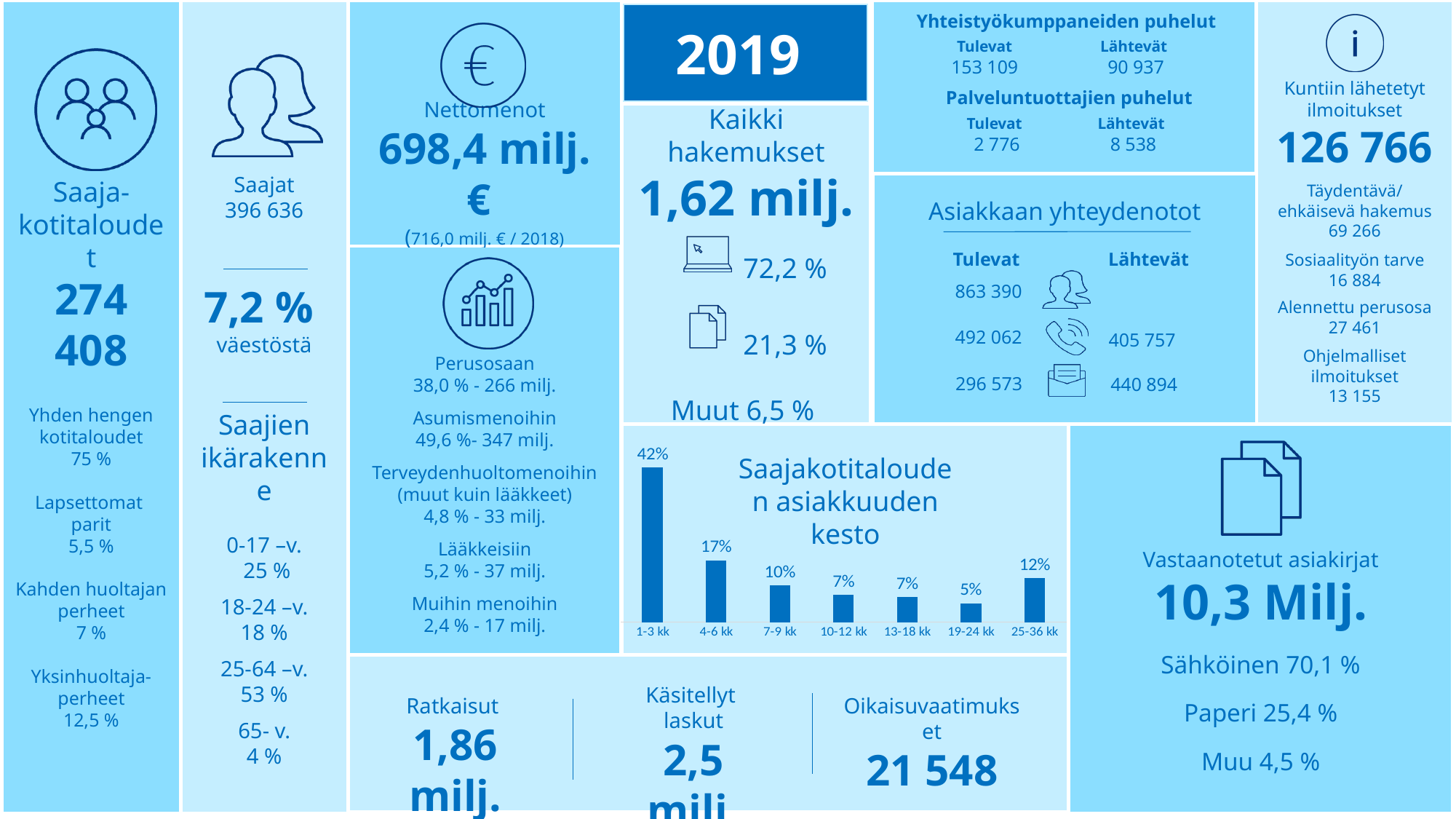
Which category has the lowest value in the Saajakotitalouden asiakkuuden kesto chart? 19-24 kk What is the value for the 4-6 kk category in the Saajakotitalouden asiakkuuden kesto chart? 17% What kind of chart is the Saajakotitalouden asiakkuuden kesto chart? Bar chart How many categories are shown in the Saajakotitalouden asiakkuuden kesto chart? 7 What is the value for the 1-3 kk category in the Saajakotitalouden asiakkuuden kesto chart? 42% Which category has the highest value in the Saajakotitalouden asiakkuuden kesto chart? 1-3 kk In the Saajakotitalouden asiakkuuden kesto chart, what is the difference between the values for 1-3 kk and 4-6 kk? 25 percentage points What is the title of the bar chart on the slide? Saajakotitalouden asiakkuuden kesto In the Saajakotitalouden asiakkuuden kesto chart, which is larger: the value for 25-36 kk or the value for 7-9 kk? 25-36 kk In the Saajakotitalouden asiakkuuden kesto chart, what is the difference between the values for 25-36 kk and 7-9 kk? 2 percentage points What is the value for the 25-36 kk category in the Saajakotitalouden asiakkuuden kesto chart? 12% What is the value for the 19-24 kk category in the Saajakotitalouden asiakkuuden kesto chart? 5%